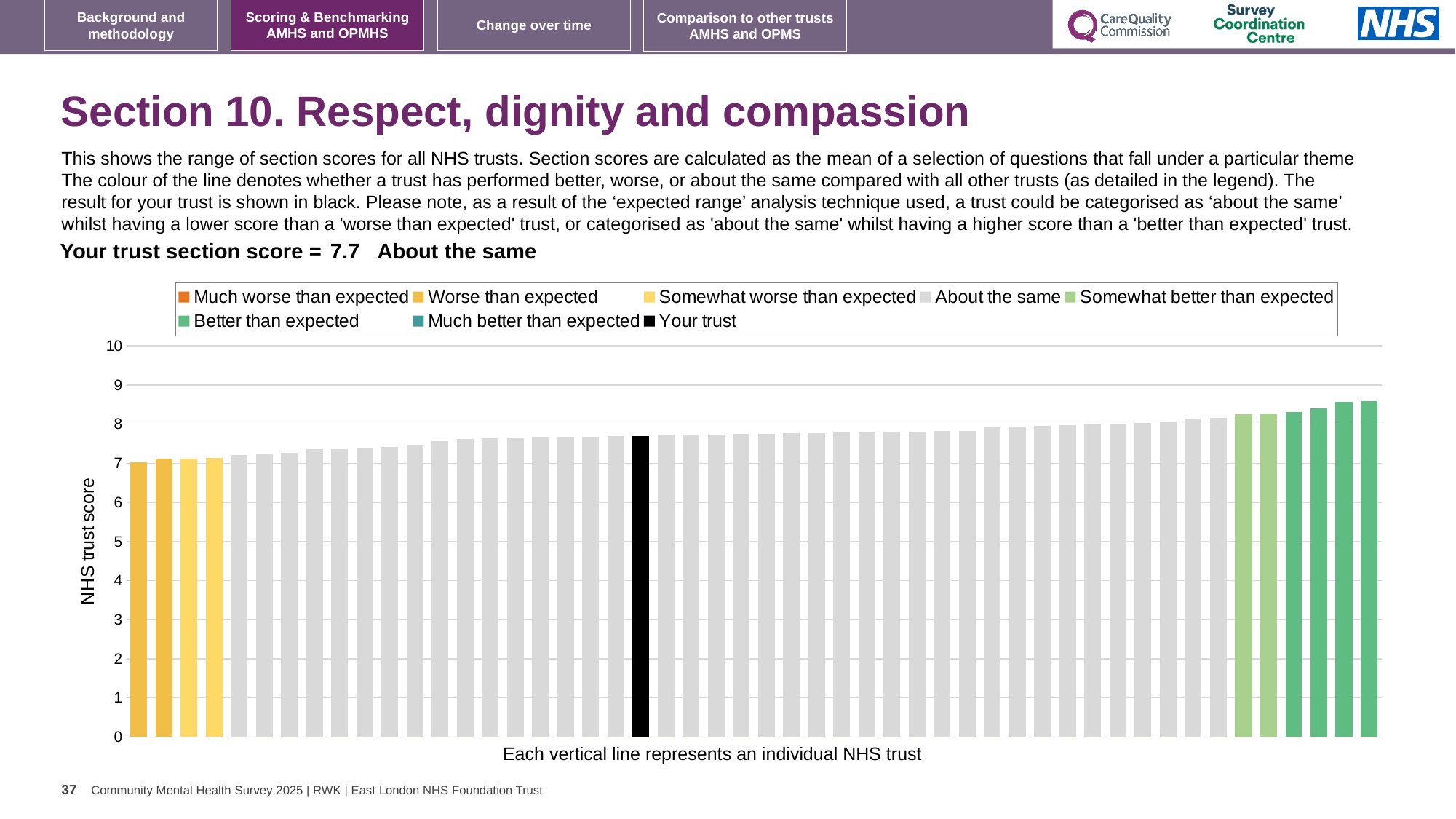
What is the section score for your trust shown on the slide? 7.7 How many entries does the chart legend list? 8 Which legend category do the tallest bars on the right of the chart belong to? Better than expected Is the value of the shortest bar greater or less than 6? greater Is the value of the black 'Your trust' bar greater or less than 7? greater How many bars are coloured as 'Better than expected' (dark green)? 4 What kind of chart is shown on the slide? bar chart Is the value of the tallest bar greater or less than 9? less Do the bar values rise or fall from left to right along the x axis? rise What is the label on the vertical axis of the chart? NHS trust score